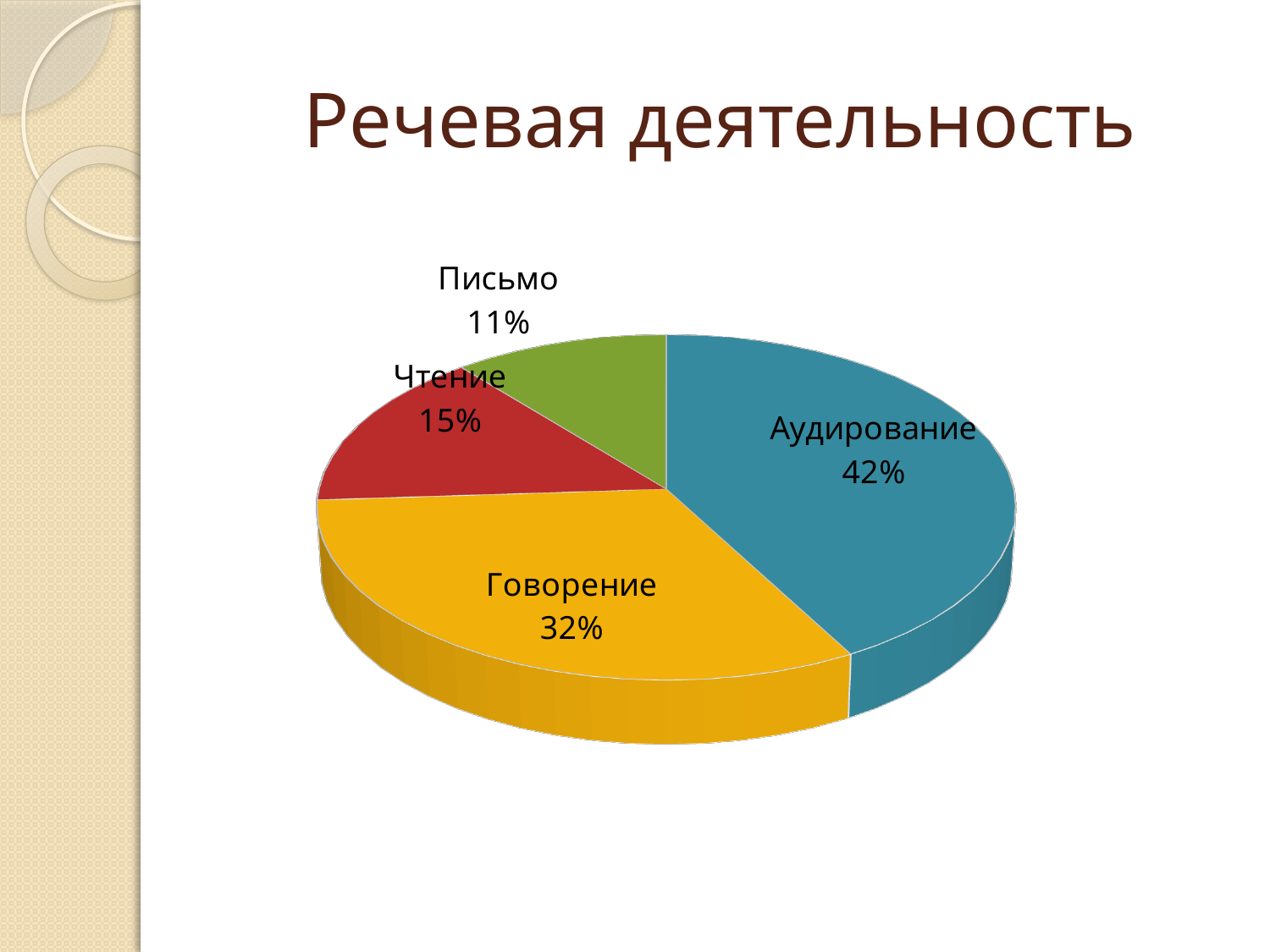
What is the difference between the shares of Аудирование and Говорение? 10% What is the title of the slide containing the chart? Речевая деятельность What kind of chart is shown on the slide? Pie chart What is the value shown for Чтение? 15% What is the value shown for Говорение? 32% Which category has the smallest slice of the pie? Письмо Which is larger, the share of Говорение or the share of Чтение? Говорение What is the difference between the shares of Чтение and Письмо? 4% What is the value shown for Письмо? 11% Which category has the largest slice of the pie? Аудирование What share of the pie does Аудирование take? 42% How many categories are shown in the pie chart? 4